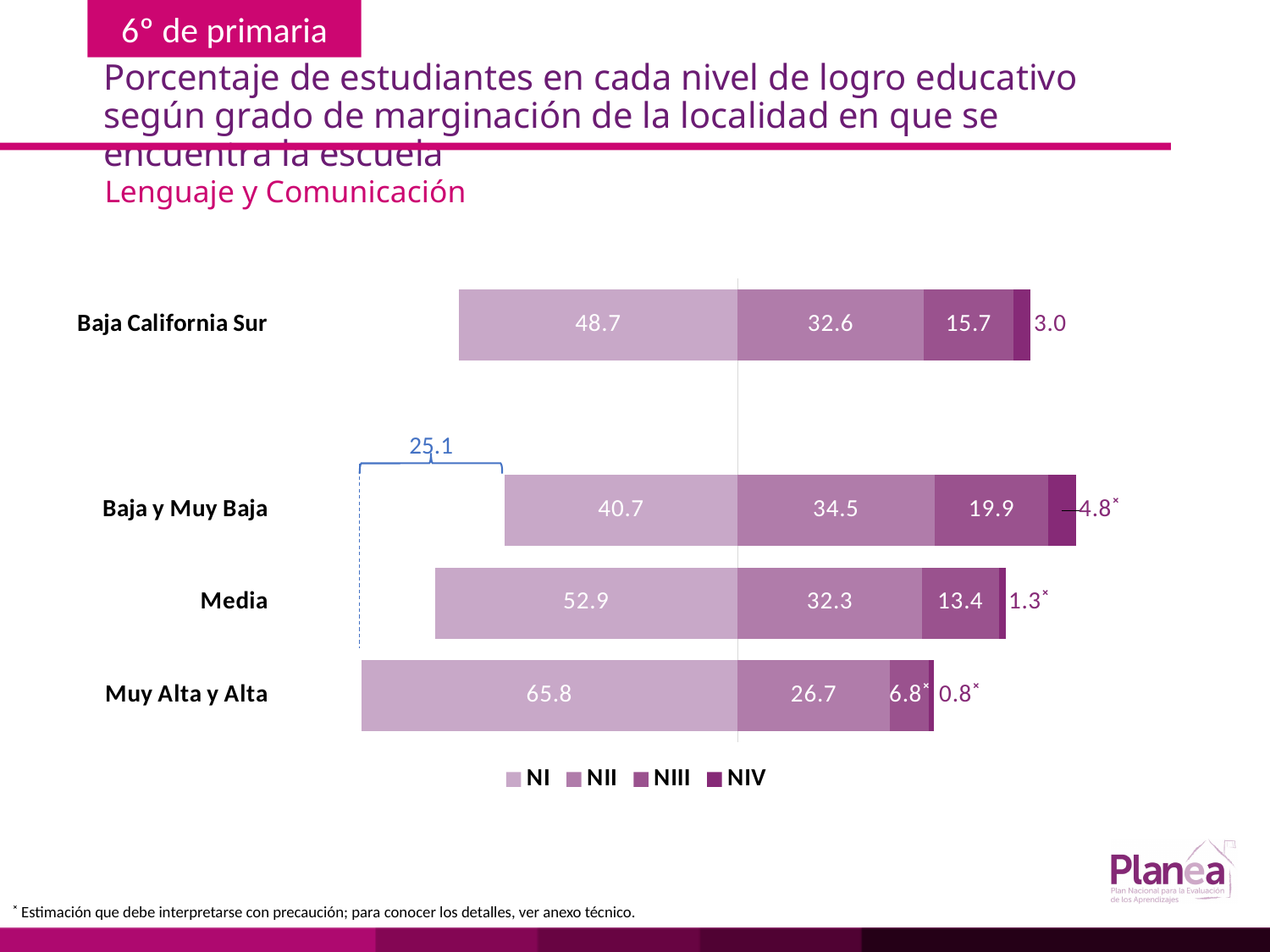
What is the difference between the NII values of Baja y Muy Baja and Muy Alta y Alta? 7.8 What is the NIII value for Baja y Muy Baja? 19.9 What is the NI value for Muy Alta y Alta? 65.8 What is the NI value for Baja California Sur? 48.7 What is the difference between the NI values of Muy Alta y Alta and Baja y Muy Baja? 25.1 What is the NII value for Media? 32.3 Which is larger, the NI value for Media or the NI value for Baja California Sur? Media Which category has the highest NI value? Muy Alta y Alta How many categories are shown on the chart? 4 How many series does the legend list? 4 Which category has the lowest NIII value? Muy Alta y Alta What kind of chart is shown on the slide? Stacked bar chart